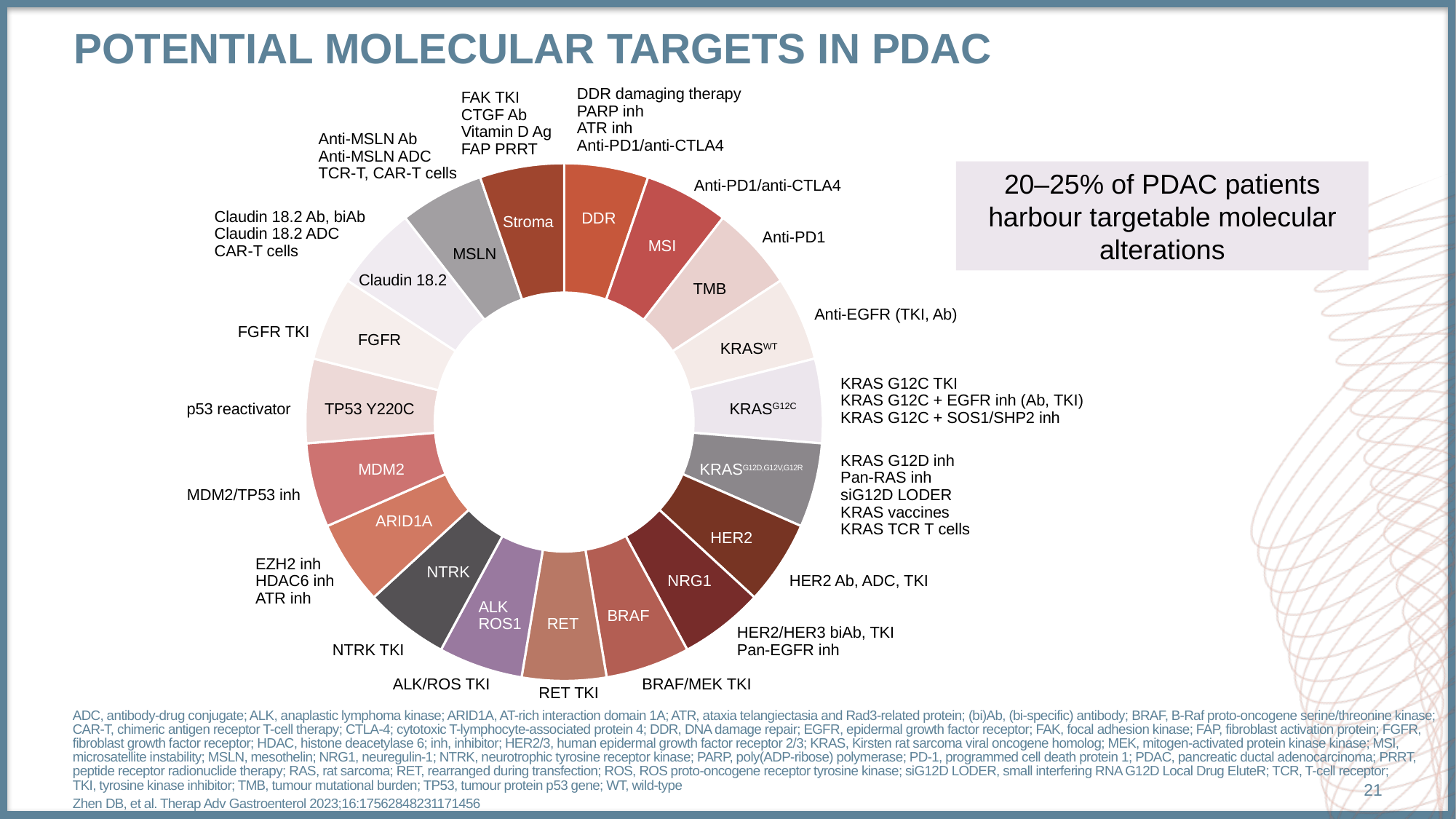
How many segments does the donut chart contain? 19 Which therapy is listed next to the BRAF segment of the chart? BRAF/MEK TKI Which therapy is listed next to the KRAS WT segment of the chart? Anti-EGFR (TKI, Ab) What kind of chart is shown on the slide? Donut (pie) chart Which therapy is listed next to the RET segment of the chart? RET TKI Which segment of the chart is labelled with the therapies EZH2 inh, HDAC6 inh and ATR inh? ARID1A According to the text box beside the chart, what percentage of PDAC patients harbour targetable molecular alterations? 20–25% What is the title of the slide containing the chart? POTENTIAL MOLECULAR TARGETS IN PDAC Which therapy is listed next to the NTRK segment of the chart? NTRK TKI Which therapy is listed next to the TP53 Y220C segment of the chart? p53 reactivator Which therapy is listed next to the FGFR segment of the chart? FGFR TKI Which therapy is listed next to the TMB segment of the chart? Anti-PD1